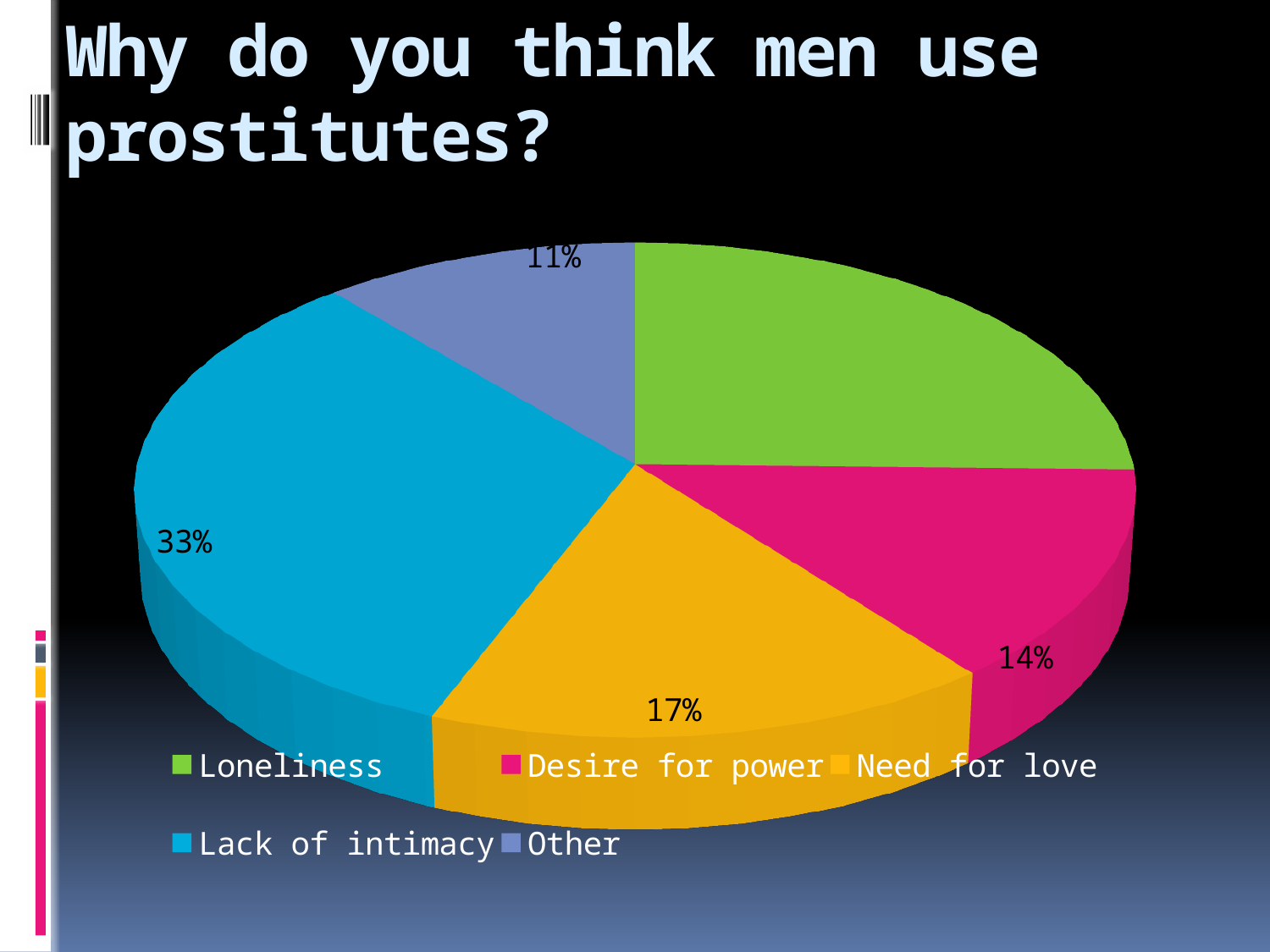
What percentage of the pie is labelled for Lack of intimacy? 33% What is the difference in percentage points between Lack of intimacy and Need for love? 16 What percentage is shown for Need for love? 17% What percentage is shown for Desire for power? 14% What is the title of the slide? Why do you think men use prostitutes? Which category has the smallest slice of the pie? Other How many categories does the pie chart show? 5 What is the difference in percentage points between Need for love and Desire for power? 3 Which category has the largest slice of the pie? Lack of intimacy What kind of chart is shown on the slide? Pie chart Which is larger, the slice for Need for love or the slice for Desire for power? Need for love What percentage is shown for the Other slice? 11%